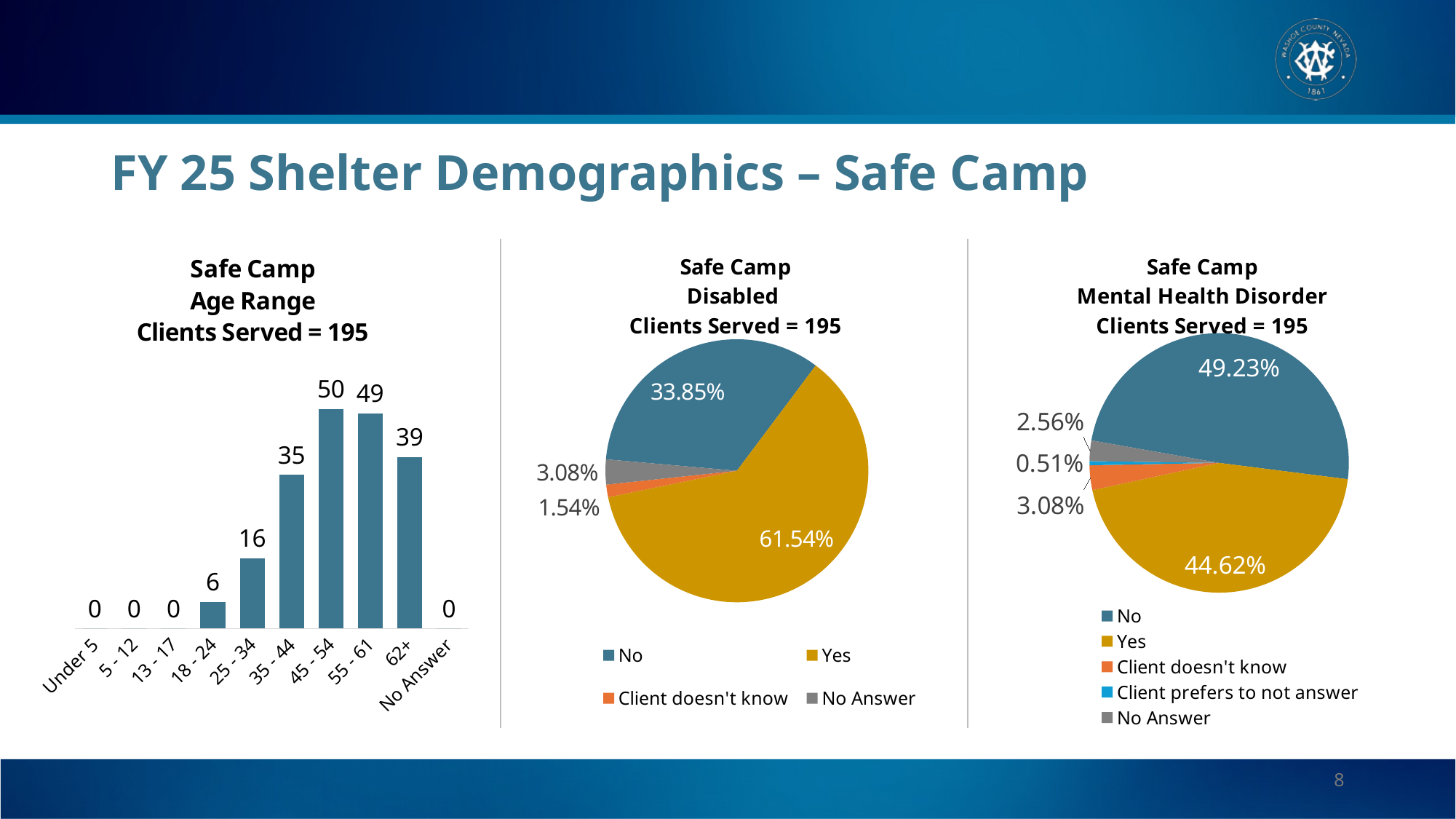
In the Safe Camp Mental Health Disorder pie chart, which category has the smallest slice? Client prefers to not answer How many age categories are shown on the x axis of the Safe Camp Age Range chart? 10 In the Safe Camp Disabled pie chart, what percentage is labelled for No Answer? 3.08% In the Safe Camp Disabled pie chart, what share of clients answered Yes? 61.54% In the Safe Camp Age Range chart, which age range has the highest number of clients? 45 - 54 In the Safe Camp Age Range chart, how many clients were in the 45 - 54 age range? 50 In the Safe Camp Age Range chart, what is the difference between the 62+ and 35 - 44 values? 4 In the Safe Camp Age Range chart, which is larger: the value for 25 - 34 or the value for 18 - 24? 25 - 34 How many entries does the legend of the Safe Camp Mental Health Disorder pie chart list? 5 In the Safe Camp Mental Health Disorder pie chart, what share of clients answered No? 49.23% How many entries does the legend of the Safe Camp Disabled pie chart list? 4 What kind of chart is the Safe Camp Age Range chart? Bar chart